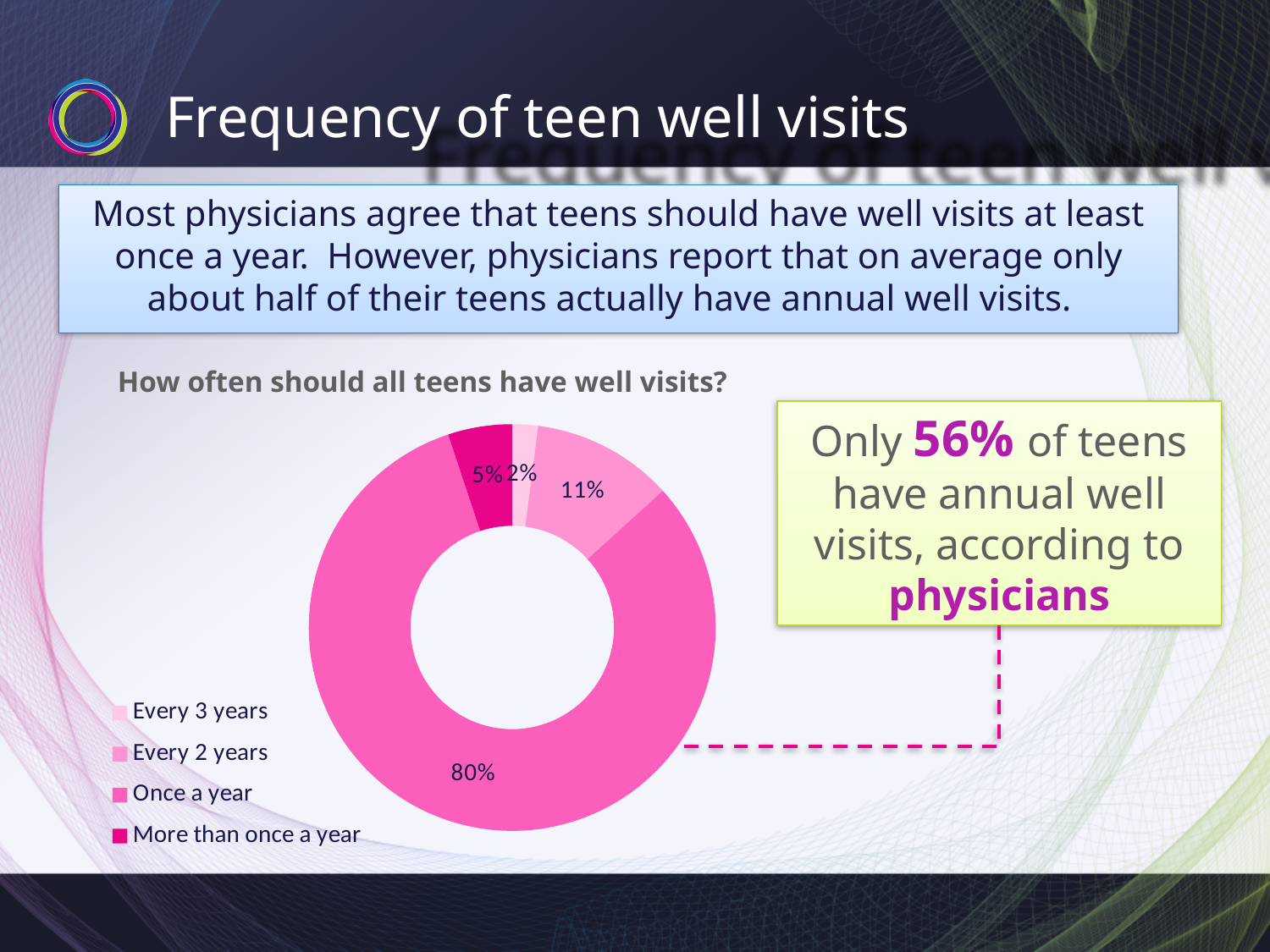
What is the title of the chart? How often should all teens have well visits? What percentage of physicians say teens should have well visits once a year? 80% What kind of chart is shown on the slide? Doughnut (pie) chart What percentage of physicians say teens should have well visits every 2 years? 11% Which response has the largest share of the chart? Once a year What is the difference in percentage points between 'Once a year' and 'Every 2 years'? 69 What percentage of physicians say teens should have well visits more than once a year? 5% Which response has the smallest share of the chart? Every 3 years What is the combined share of 'Every 2 years' and 'Every 3 years'? 13% What percentage of physicians say teens should have well visits every 3 years? 2% Which is larger: the share for 'More than once a year' or the share for 'Every 3 years'? More than once a year How many categories does the chart show? 4